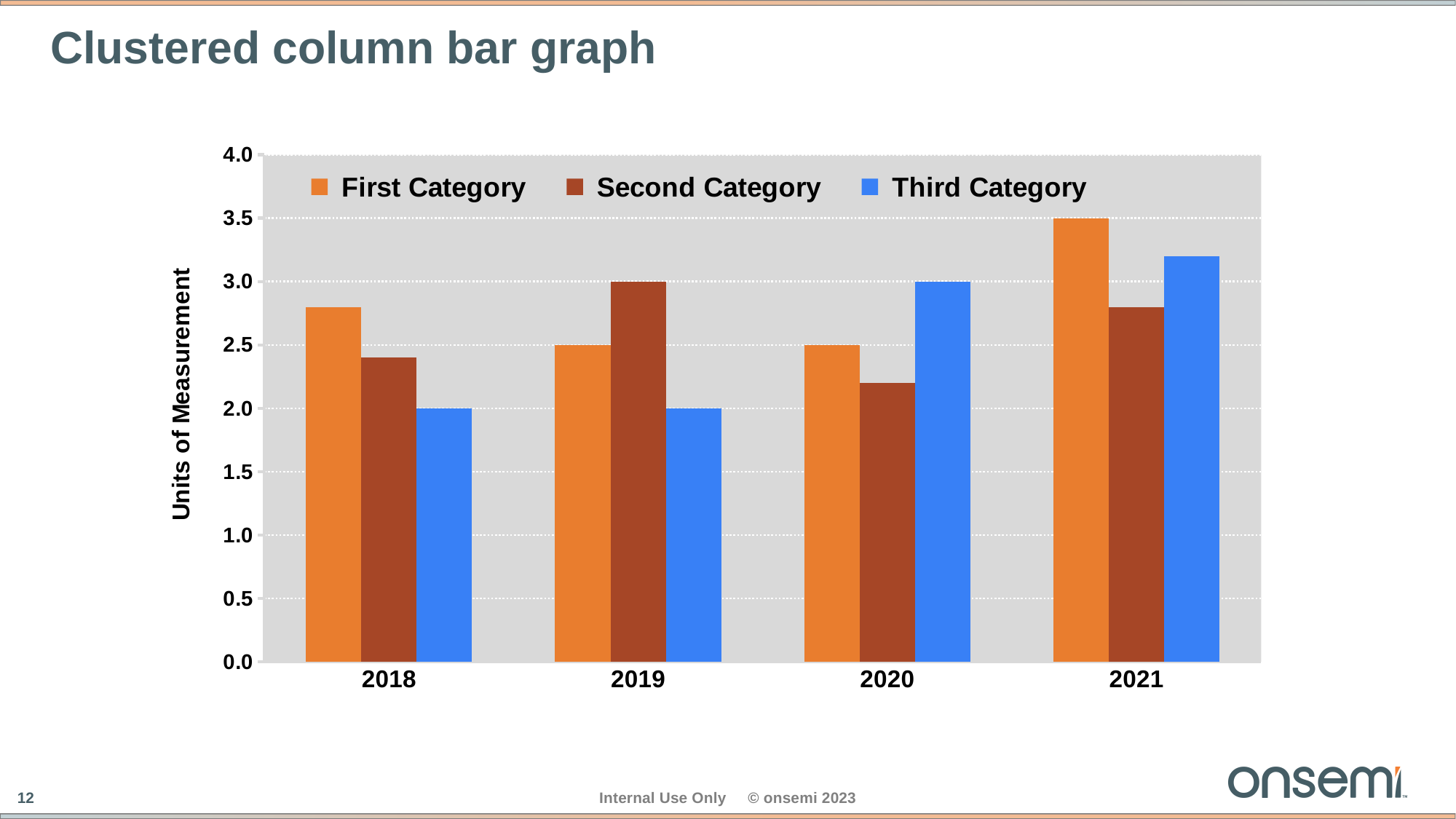
Which is larger in 2019, First Category or Second Category? Second Category What is the label on the vertical axis? Units of Measurement What kind of chart is shown on the slide? bar chart How many years are shown on the x axis? 4 Is the value for First Category in 2018 greater or less than 2.5? greater In which year is the First Category bar highest? 2021 What is the value for Third Category in 2018? 2.0 What is the value for First Category in 2021? 3.5 What is the value for Third Category in 2020? 3.0 Is the value for Second Category in 2020 greater or less than 2.5? less What is the value for Second Category in 2019? 3.0 How many series does the legend list? 3